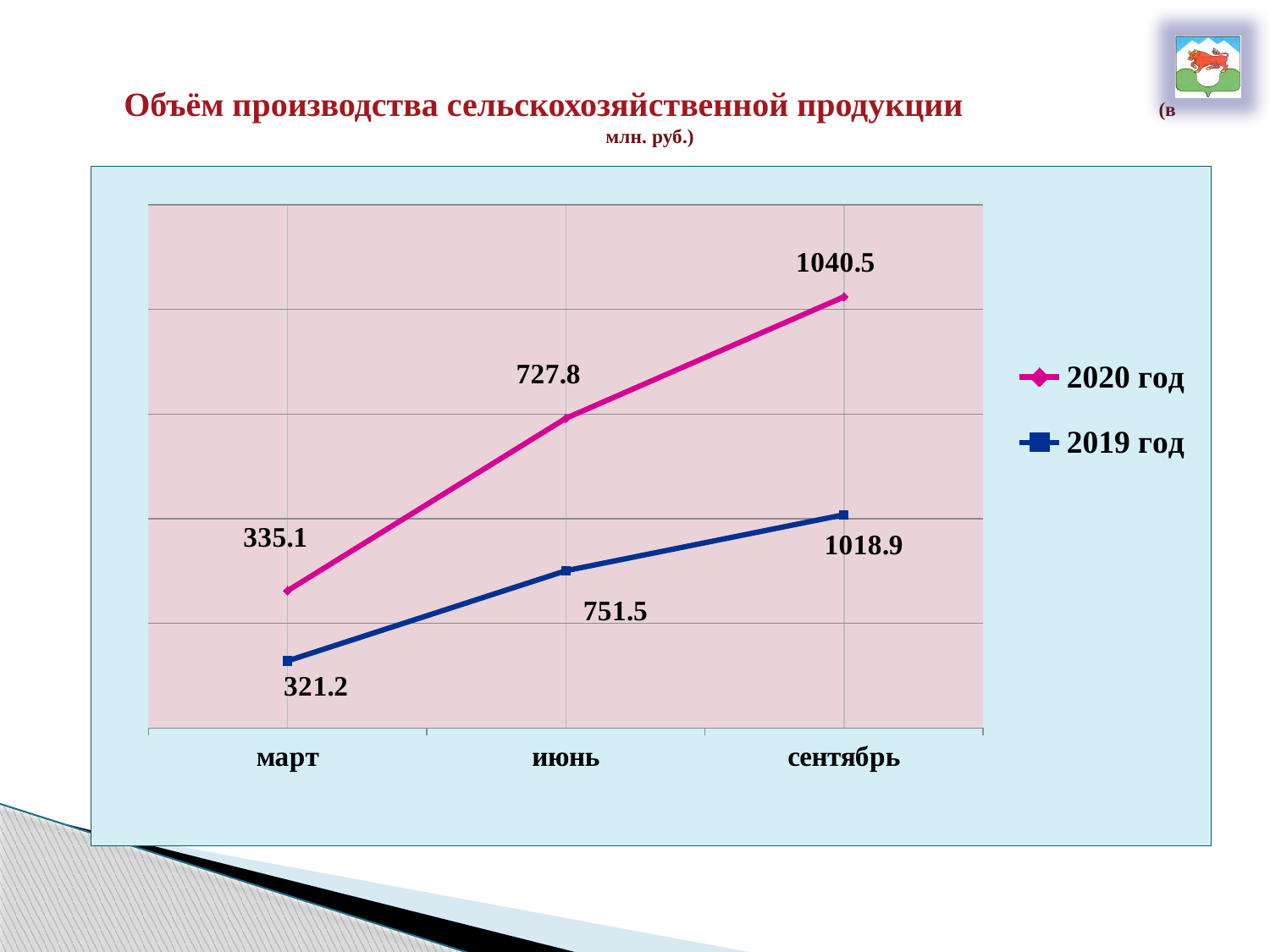
What is the value for 2020 год in сентябрь? 1040.5 What is the value for 2019 год in сентябрь? 1018.9 Which series has the larger value in сентябрь, 2020 год or 2019 год? 2020 год What type of chart is shown on the slide? line chart What is the value for 2019 год in июнь? 751.5 What is the difference between the 2020 год values for сентябрь and март? 705.4 In which month is the value for 2019 год the lowest? март How many series does the legend list? 2 In which month is the value for 2020 год the highest? сентябрь What is the value for 2020 год in март? 335.1 How many points are plotted along the x axis for each series? 3 Do the values for 2020 год rise or fall from март to сентябрь? rise